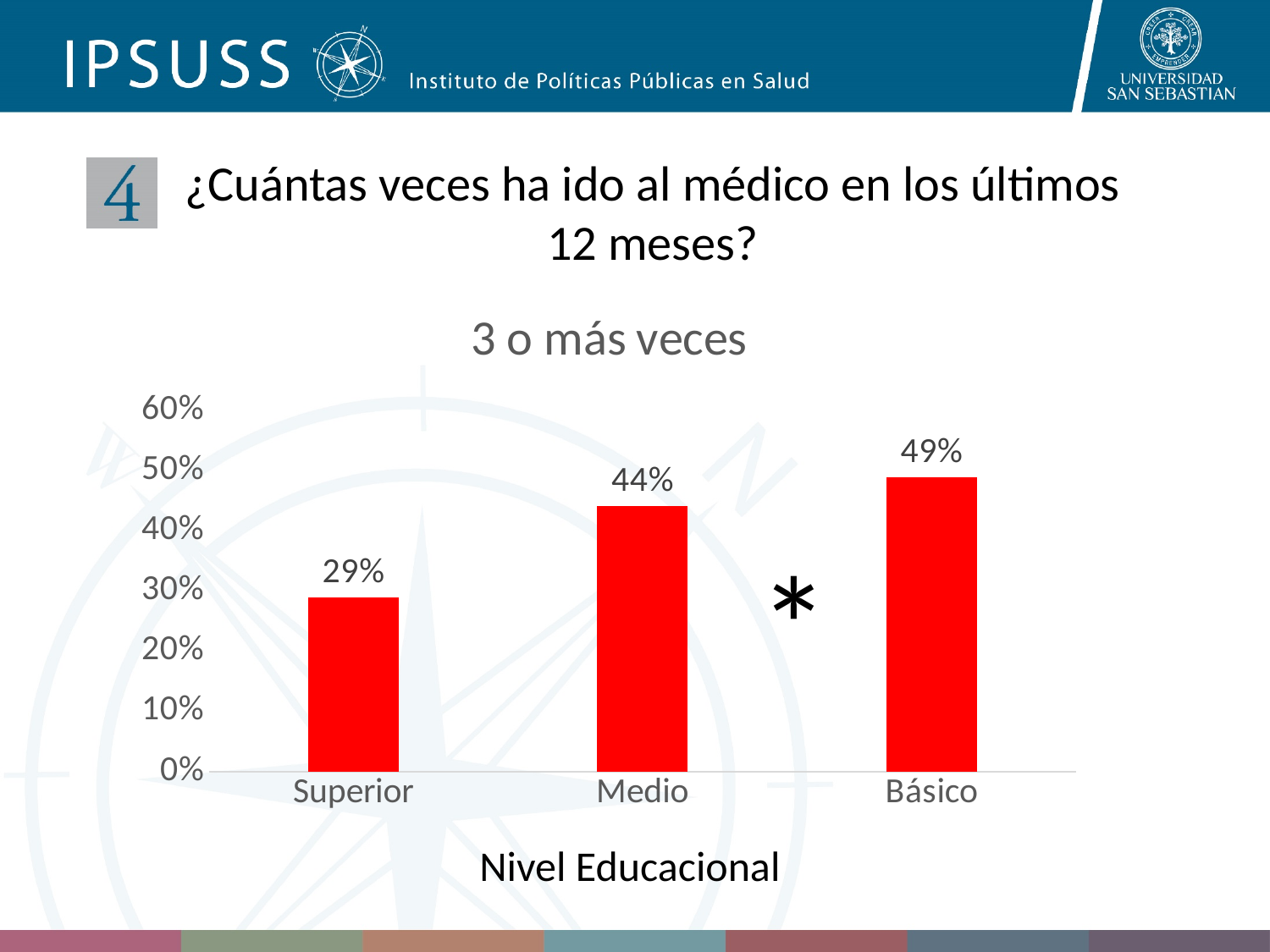
What is the title of the chart? 3 o más veces What is the value for Medio? 44% What kind of chart is shown on the slide? bar chart Is the value for Básico greater or less than 40%? greater What is the difference between the values for Básico and Superior? 20% Which is larger, the value for Medio or the value for Superior? Medio What is the difference between the values for Medio and Superior? 15% What is the value for Superior? 29% Which educational level has the highest value? Básico Which educational level has the lowest value? Superior How many educational levels are shown on the x axis? 3 What is the value for Básico? 49%